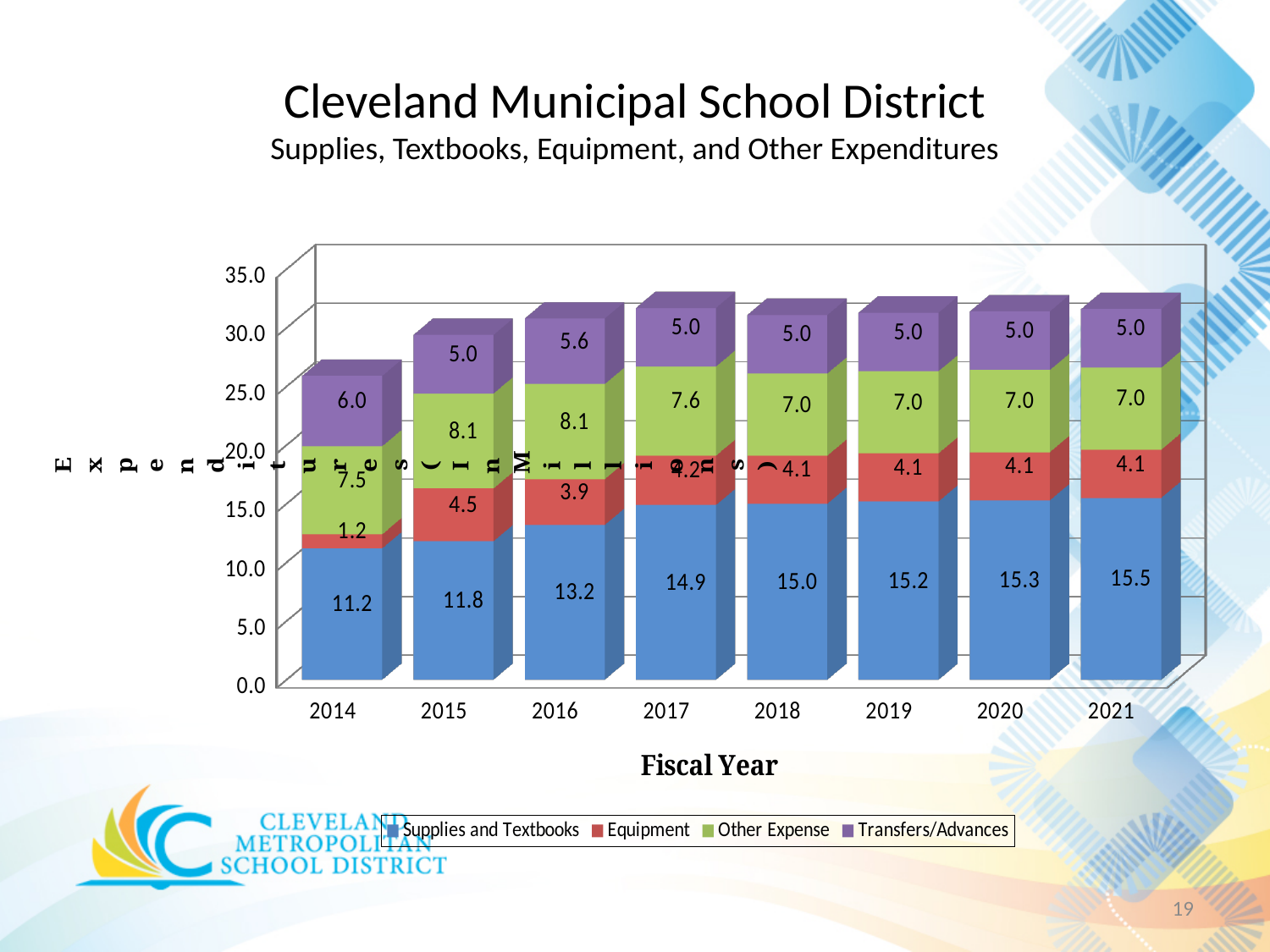
How many fiscal years are shown on the x axis? 8 What is the total of the stacked bar for fiscal year 2021? 31.6 What is the value for Equipment in fiscal year 2015? 4.5 What is the difference between the Supplies and Textbooks values for 2021 and 2014? 4.3 Do the Supplies and Textbooks values rise or fall from 2014 to 2021? rise What kind of chart is shown on the slide? stacked bar chart Which is larger, the Other Expense value for 2015 or for 2021? 2015 What is the value for Supplies and Textbooks in fiscal year 2021? 15.5 In which fiscal year is the Supplies and Textbooks value highest? 2021 What is the value for Transfers/Advances in fiscal year 2016? 5.6 In which fiscal year is the Equipment value lowest? 2014 How many series does the legend list? 4